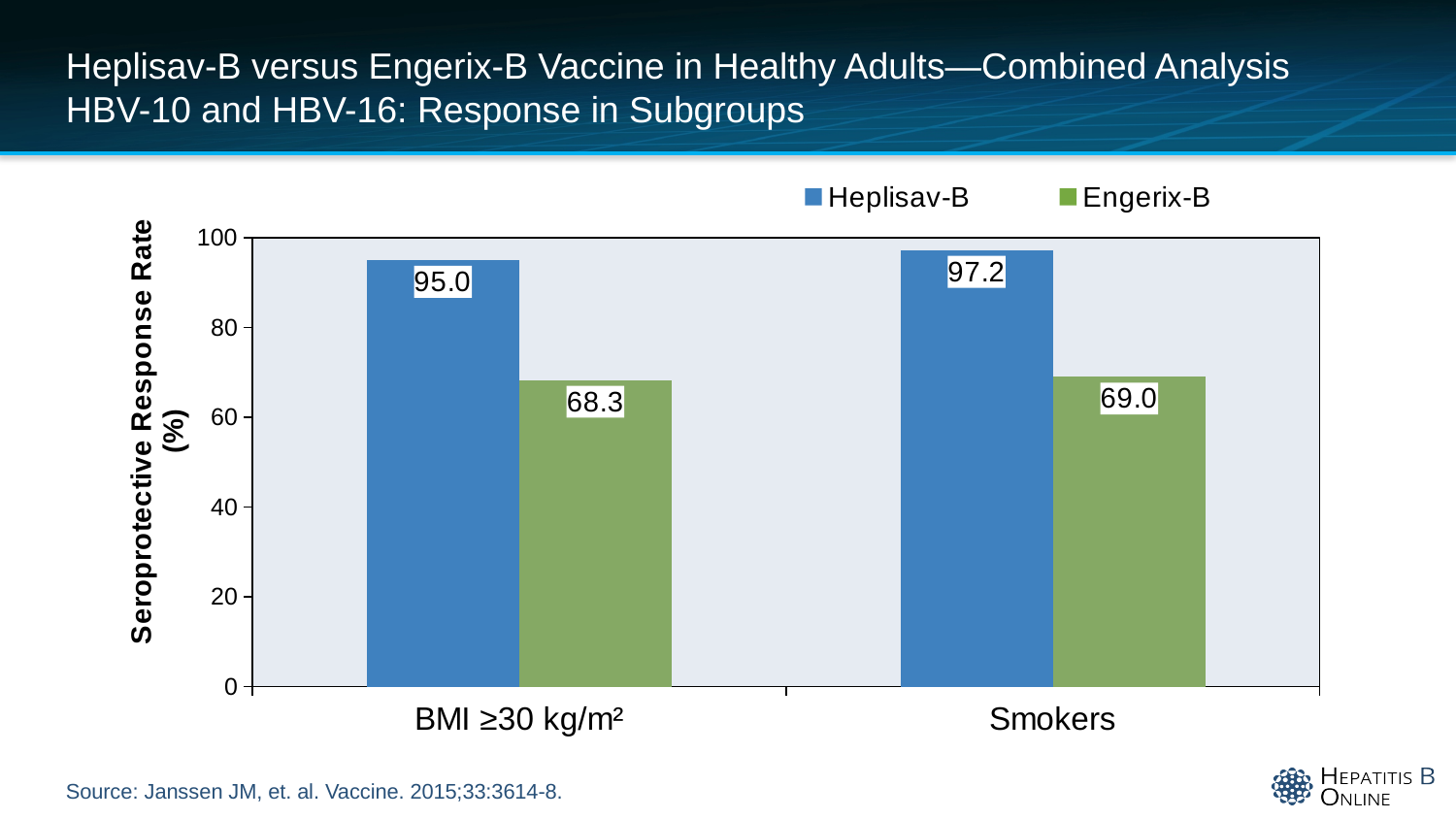
How many subgroup categories are shown on the x axis? 2 Which vaccine has the higher seroprotective response rate among Smokers? Heplisav-B Which bar shows the lowest seroprotective response rate on the chart? Engerix-B, BMI ≥30 kg/m² What is the difference between the Heplisav-B and Engerix-B response rates among Smokers? 28.2 Which bar shows the highest seroprotective response rate on the chart? Heplisav-B, Smokers What type of chart is shown on the slide? Bar chart How many series does the legend list? 2 What is the seroprotective response rate for Heplisav-B among Smokers? 97.2 What is the seroprotective response rate for Engerix-B in the BMI ≥30 kg/m² subgroup? 68.3 What is the seroprotective response rate for Engerix-B among Smokers? 69.0 What is the seroprotective response rate for Heplisav-B in the BMI ≥30 kg/m² subgroup? 95.0 What is the difference between the Heplisav-B and Engerix-B response rates in the BMI ≥30 kg/m² subgroup? 26.7